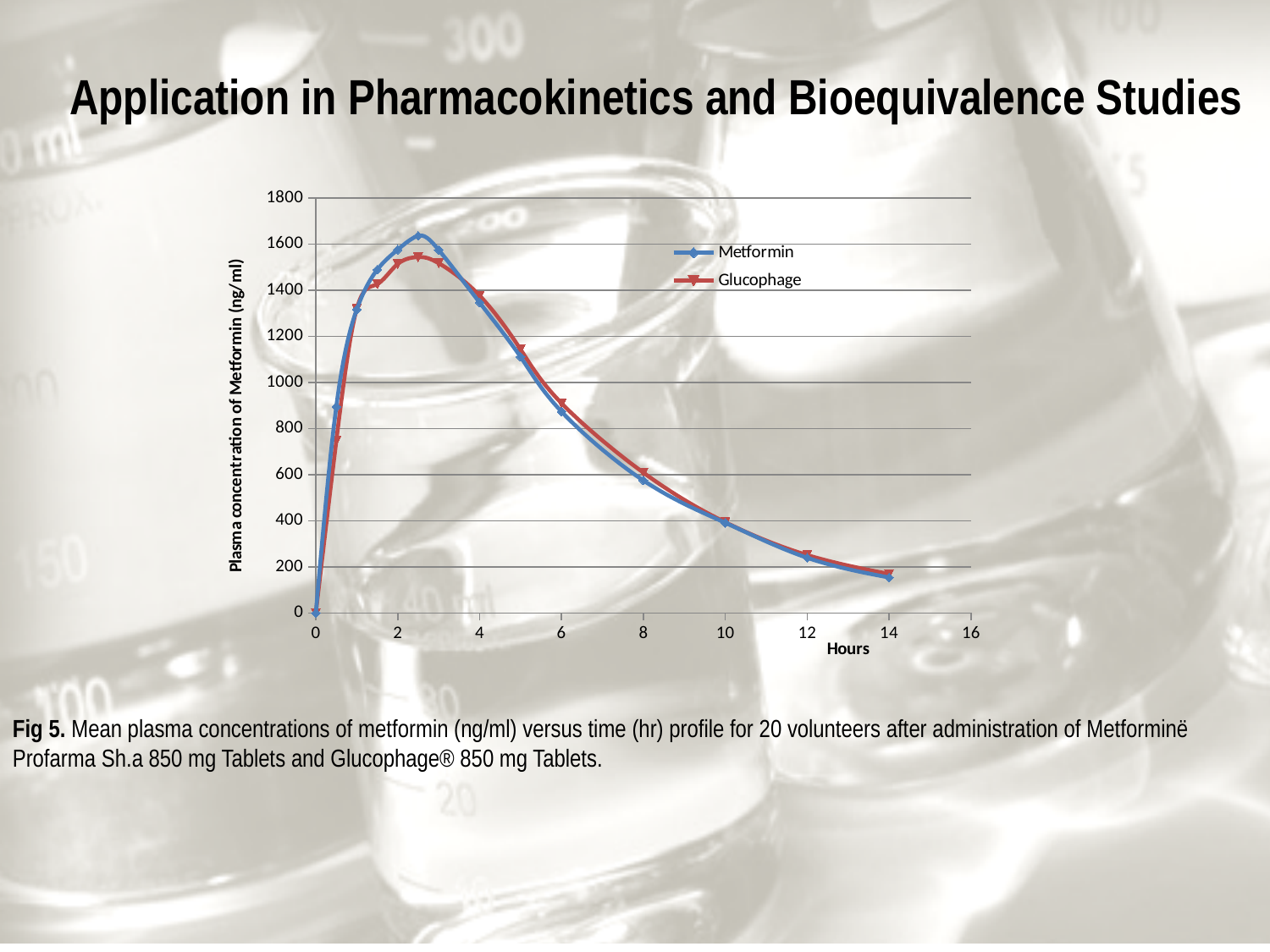
Is the Metformin value at 2 hours greater or less than 1400? greater What are the two series named in the chart's legend? Metformin and Glucophage What kind of chart is shown on the slide? line chart Is the Metformin value at 1 hour greater or less than 1000? greater Which series reaches the higher peak concentration, Metformin or Glucophage? Metformin What is the Metformin plasma concentration at 0 hours? 0 Is the Glucophage value at 6 hours greater or less than 800? greater What is the label on the chart's vertical axis? Plasma concentration of Metformin (ng/ml) After about 4 hours, do the plasma concentrations rise or fall as time increases? fall How many series does the chart's legend list? 2